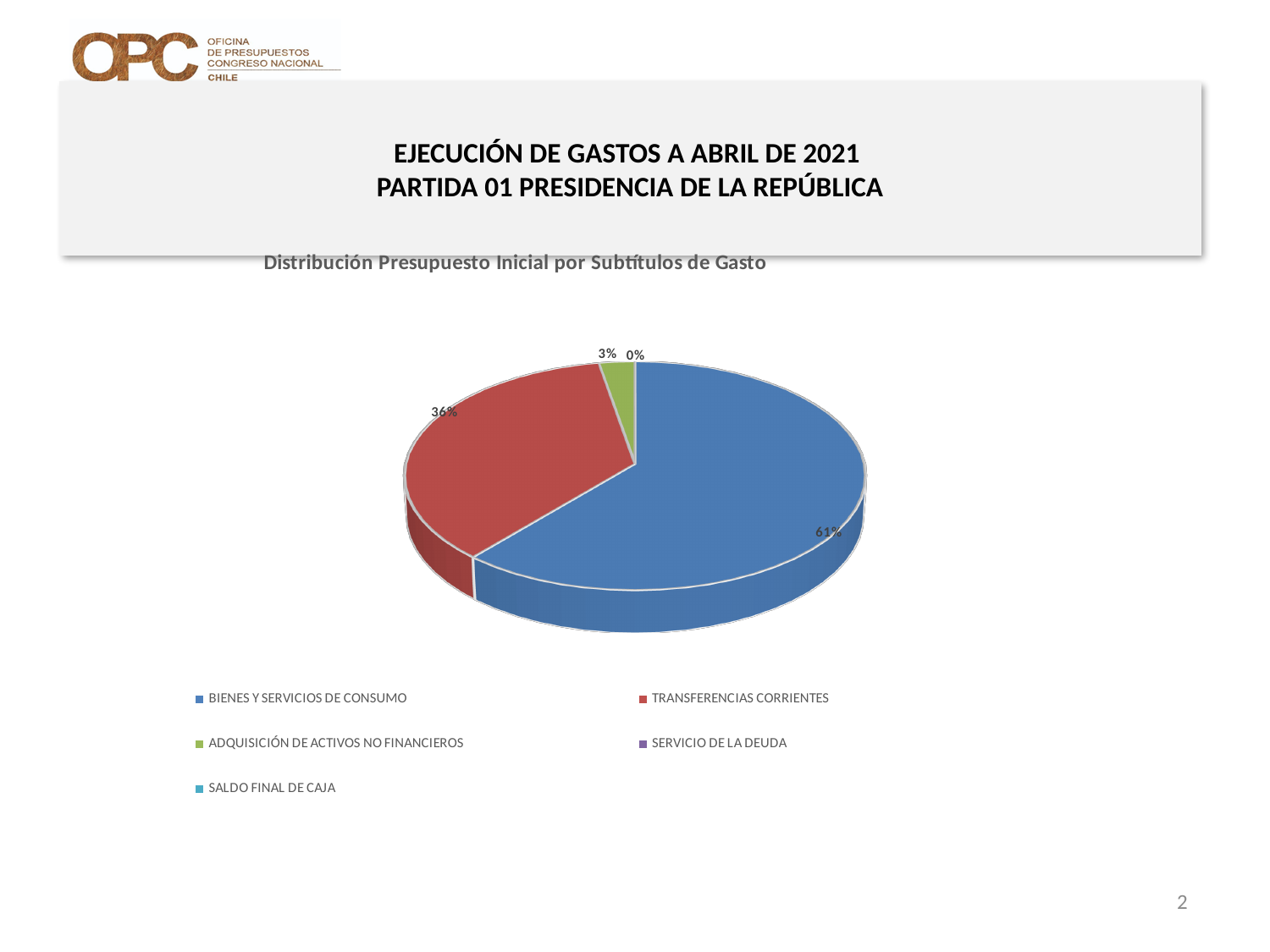
What share of the pie does BIENES Y SERVICIOS DE CONSUMO represent? 61% What percentage is shown for TRANSFERENCIAS CORRIENTES? 36% What percentage is shown for SERVICIO DE LA DEUDA? 0% Which colour represents TRANSFERENCIAS CORRIENTES in the pie chart? Red Which category has the largest slice of the pie? BIENES Y SERVICIOS DE CONSUMO What percentage is shown for ADQUISICIÓN DE ACTIVOS NO FINANCIEROS? 3% Which is larger, the slice for TRANSFERENCIAS CORRIENTES or the slice for ADQUISICIÓN DE ACTIVOS NO FINANCIEROS? TRANSFERENCIAS CORRIENTES How many categories does the legend list? 5 Is the share for TRANSFERENCIAS CORRIENTES greater or less than 50%? less What is the difference in percentage points between BIENES Y SERVICIOS DE CONSUMO and TRANSFERENCIAS CORRIENTES? 25 percentage points What is the title of the chart? Distribución Presupuesto Inicial por Subtítulos de Gasto What type of chart is shown on the slide? Pie chart